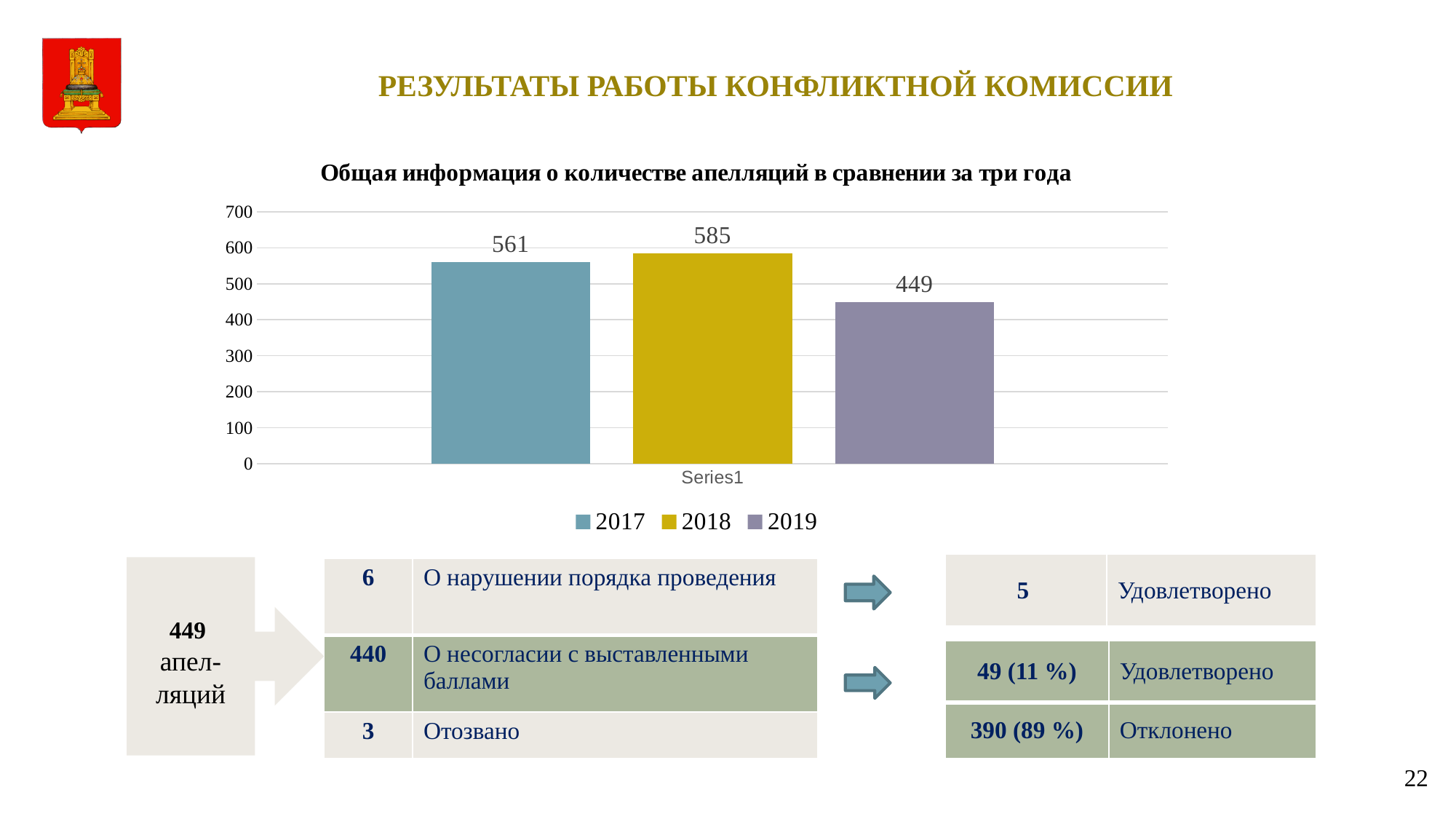
Is the value for 2019 greater or less than 500? less What is the difference between the values for 2017 and 2019? 112 Which year has the lowest value in the chart? 2019 What kind of chart is shown on the slide? bar chart What is the difference between the values for 2018 and 2019? 136 How many series does the legend list? 3 Which is larger, the value for 2017 or the value for 2019? 2017 What is the value for 2019 in the chart? 449 What is the value for 2018 in the chart? 585 What is the title of the chart? Общая информация о количестве апелляций в сравнении за три года Which year has the highest value in the chart? 2018 What is the value for 2017 in the chart? 561